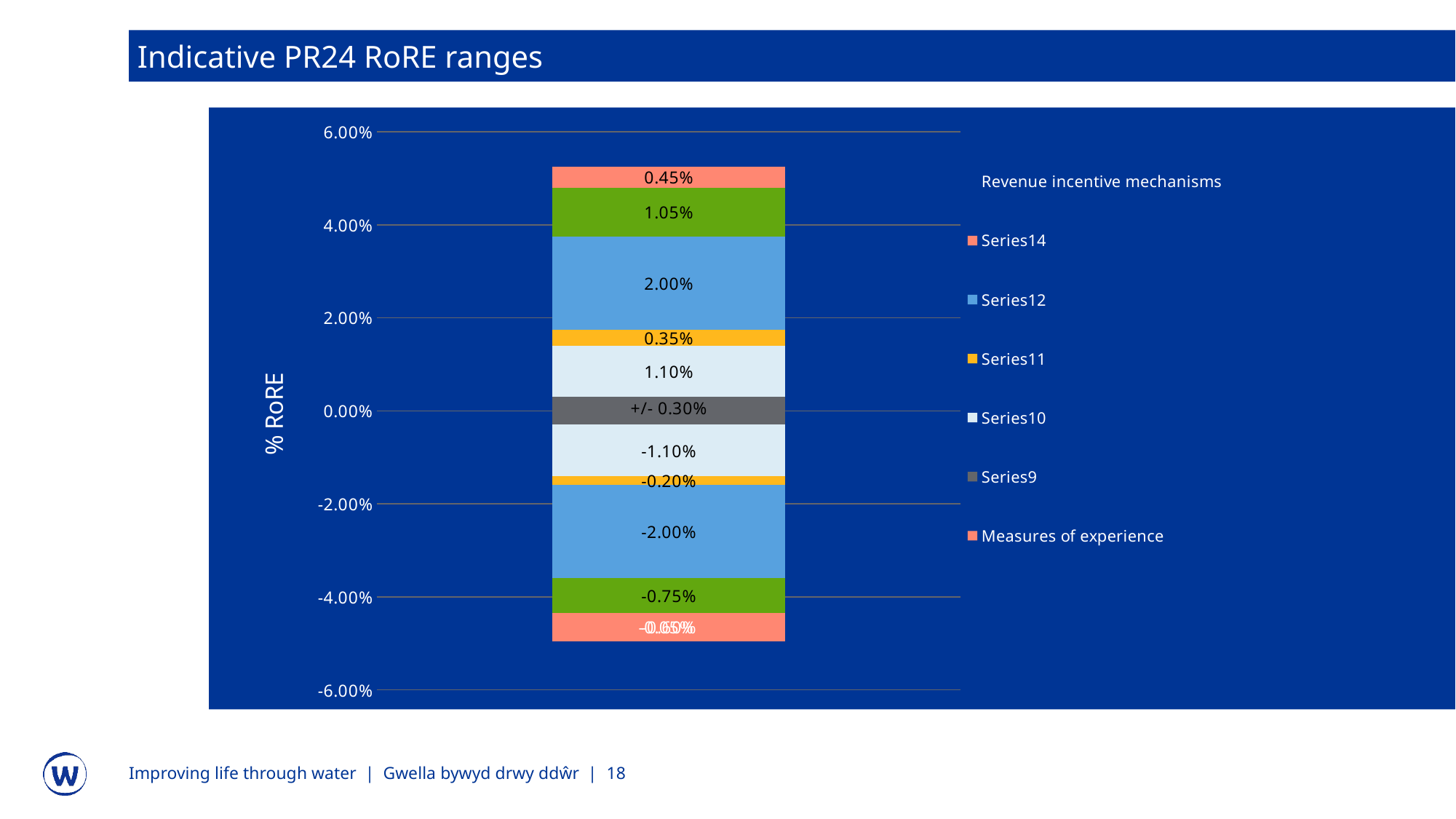
What value is labelled on the dark grey segment of the bar? +/- 0.30% How many series does the chart legend list? 6 What value is labelled on the lower green segment of the bar? -0.75% What is the label on the vertical axis of the chart? % RoRE What kind of chart is shown on the slide? Stacked bar chart How many categories are plotted on the x axis of the chart? 1 What value is labelled on the upper green segment of the bar? 1.05% What value is labelled on the topmost (salmon) segment of the bar? 0.45% What is the difference between the upper blue segment (2.00%) and the upper green segment (1.05%)? 0.95% Which labelled segment of the bar has the largest positive value? 2.00% What is the category label shown for the stacked bar? Revenue incentive mechanisms Is the top of the stacked bar greater or less than 4.00%? greater